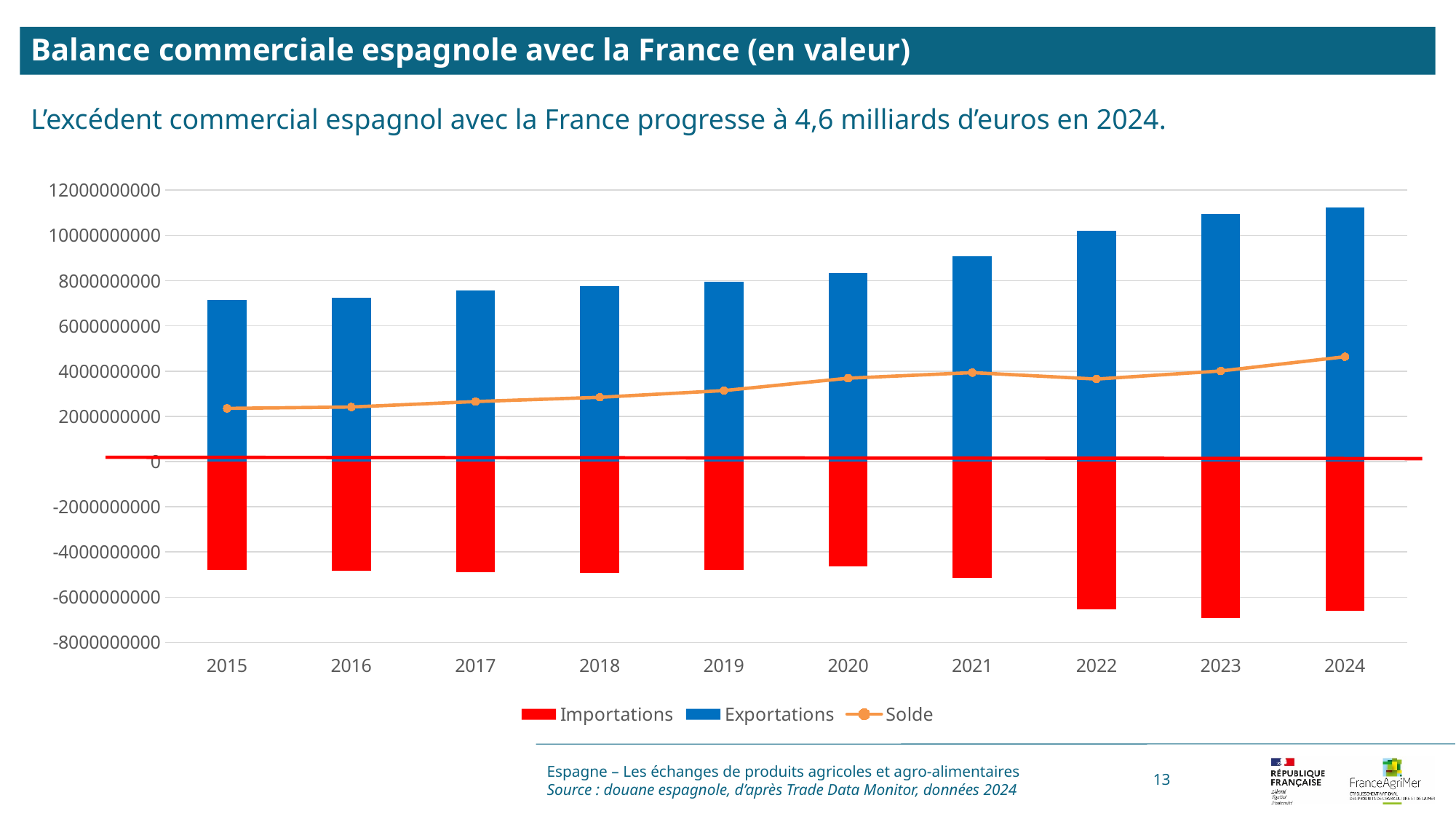
How many years are shown on the x axis of the chart? 10 Which year has the highest Solde value? 2024 Is the Solde value for 2024 greater or less than 4000000000? greater Which is larger, the Exportations value for 2024 or for 2015? 2024 Is the Exportations value for 2015 greater or less than 8000000000? less What kind of chart is shown on the slide? Combined bar and line chart Do the Exportations values rise or fall from 2015 to 2024? Rise How many series does the chart legend list? 3 Is the Exportations value for 2024 greater or less than 10000000000? greater Which year has the highest Exportations value? 2024 What is the title of the chart on the slide? Balance commerciale espagnole avec la France (en valeur) Which year has the lowest Exportations value? 2015